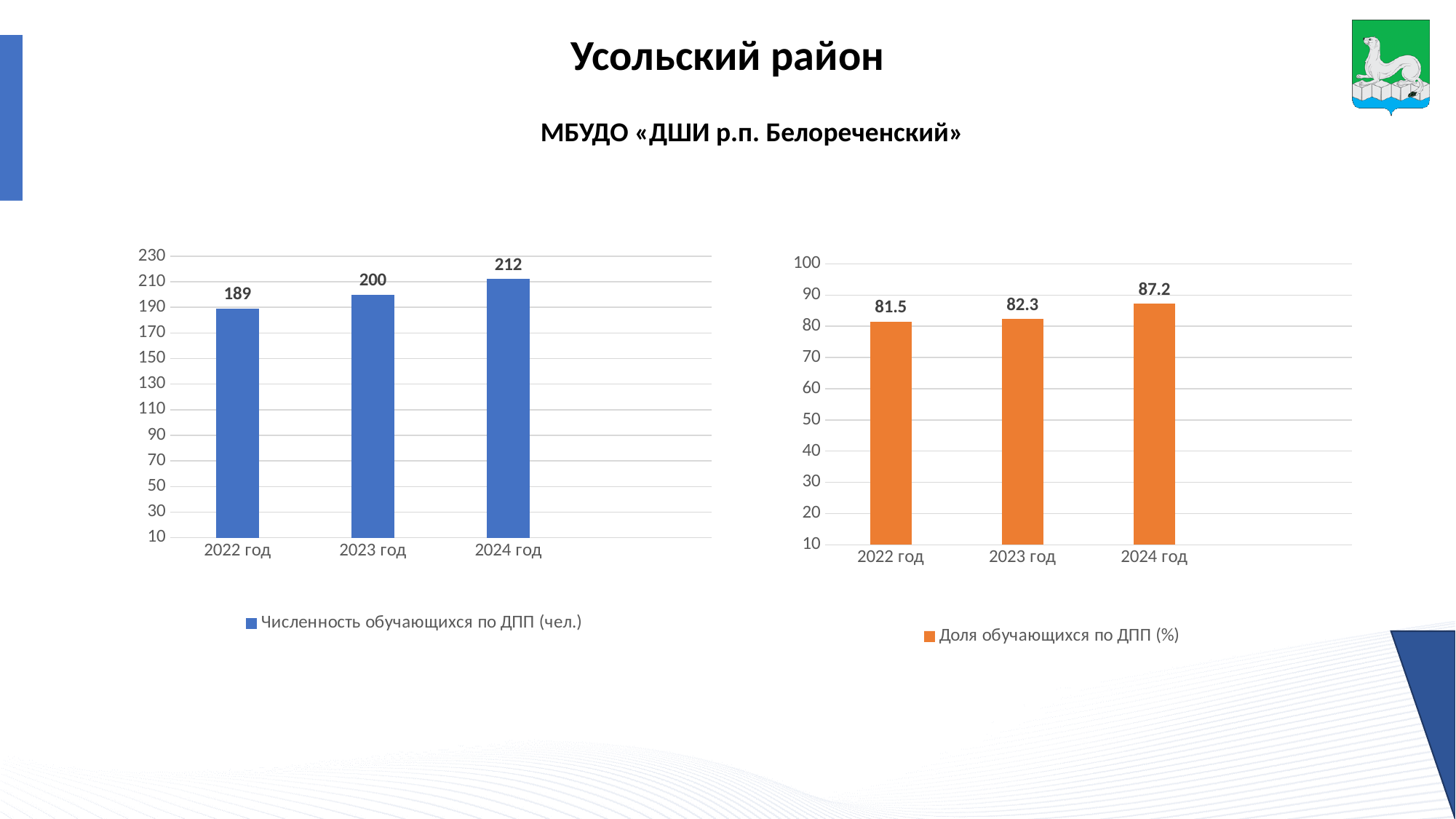
In the left chart (Численность обучающихся по ДПП), which year has the highest value? 2024 год What type of chart is the right chart (Доля обучающихся по ДПП)? bar chart In the right chart (Доля обучающихся по ДПП), is the value for 2022 год greater or less than 90? less In the left chart (Численность обучающихся по ДПП), what is the value for 2023 год? 200 In the right chart (Доля обучающихся по ДПП), what is the difference between the values for 2023 год and 2022 год? 0.8 How many years are shown on the x axis of the left chart (Численность обучающихся по ДПП)? 3 In the right chart (Доля обучающихся по ДПП), which year has the lowest value? 2022 год In the left chart (Численность обучающихся по ДПП), which is larger: the value for 2022 год or 2023 год? 2023 год What is the legend entry of the right chart? Доля обучающихся по ДПП (%) In the left chart (Численность обучающихся по ДПП), what is the difference between the values for 2024 год and 2022 год? 23 In the left chart (Численность обучающихся по ДПП), do the values rise or fall from 2022 год to 2024 год? rise In the right chart (Доля обучающихся по ДПП), what is the value for 2024 год? 87.2